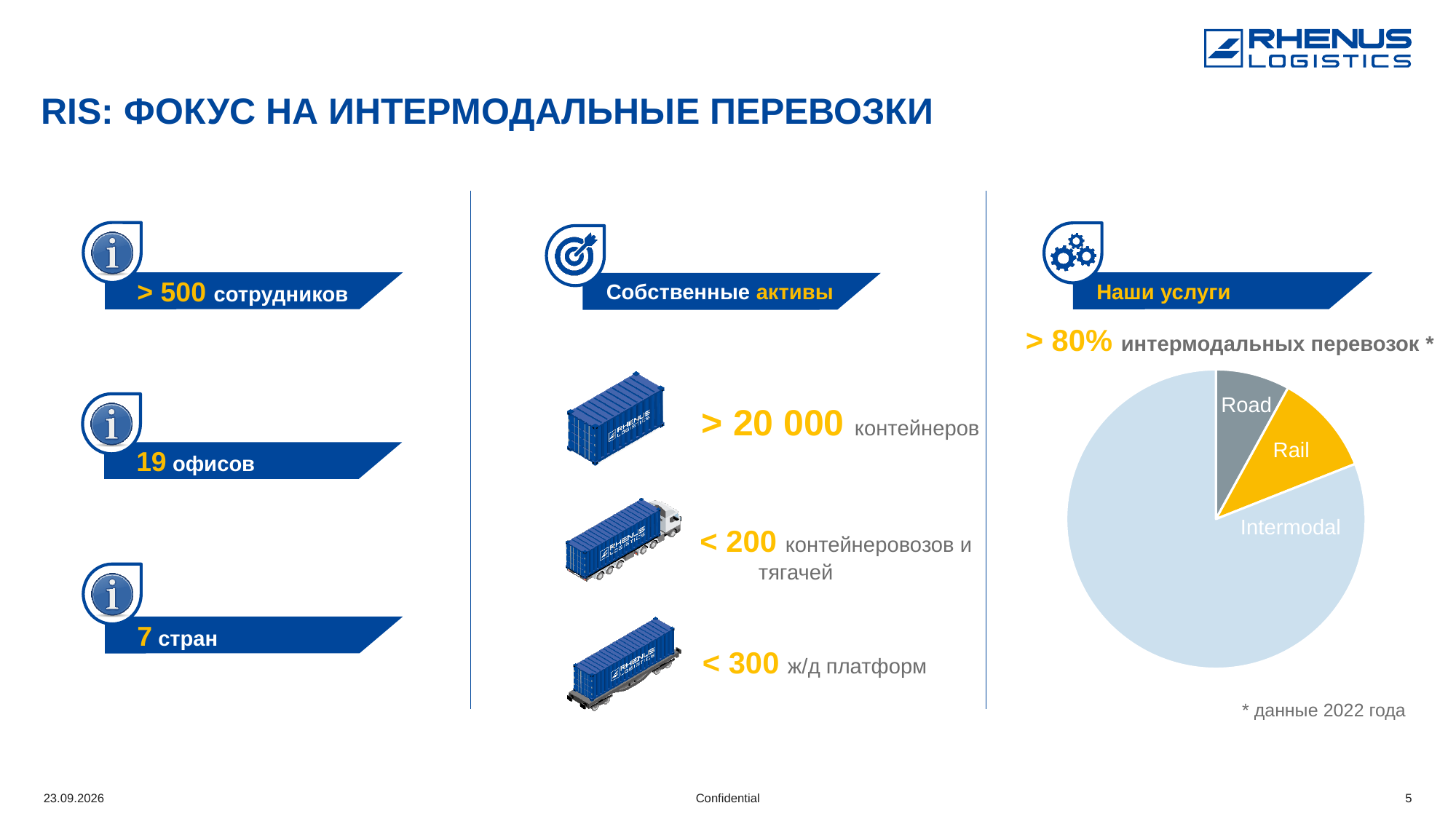
What colour is the Rail slice in the pie chart? yellow How many slices does the pie chart have? 3 What kind of chart is shown under the heading "Наши услуги"? pie chart What are the labels of the three slices in the pie chart? Road, Rail, Intermodal In the pie chart, which slice is larger, Intermodal or Road? Intermodal In the pie chart, which slice is larger, Intermodal or Rail? Intermodal Which slice of the pie chart is the largest? Intermodal According to the footnote under the pie chart, which year's data does it show? 2022